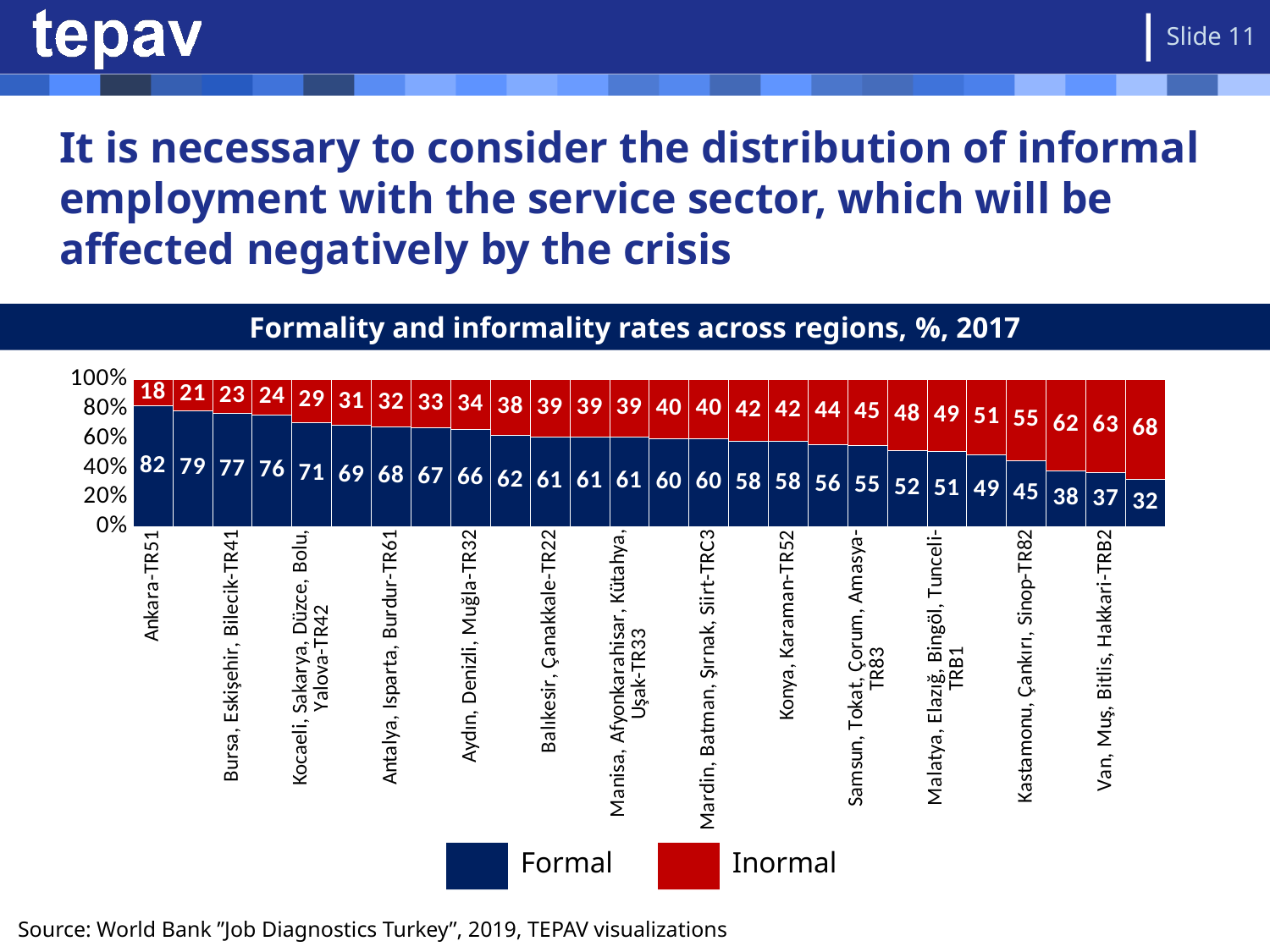
Is the Formal value for Ankara-TR51 greater or less than 80%? greater Do the Formal values rise or fall moving from left to right along the x axis? Fall What is the Inormal value of the rightmost bar in the chart? 68 What are the two series named in the legend? Formal and Inormal What is the Inormal value for Ankara-TR51? 18 What is the Formal value for Ankara-TR51? 82 What is the difference between the Formal and Inormal values for Ankara-TR51? 64 Which region has the highest Formal value? Ankara-TR51 What is the title of the chart? Formality and informality rates across regions, %, 2017 What is the Formal value of the rightmost bar in the chart? 32 What type of chart is shown on the slide? Stacked bar chart How many series does the legend list? 2